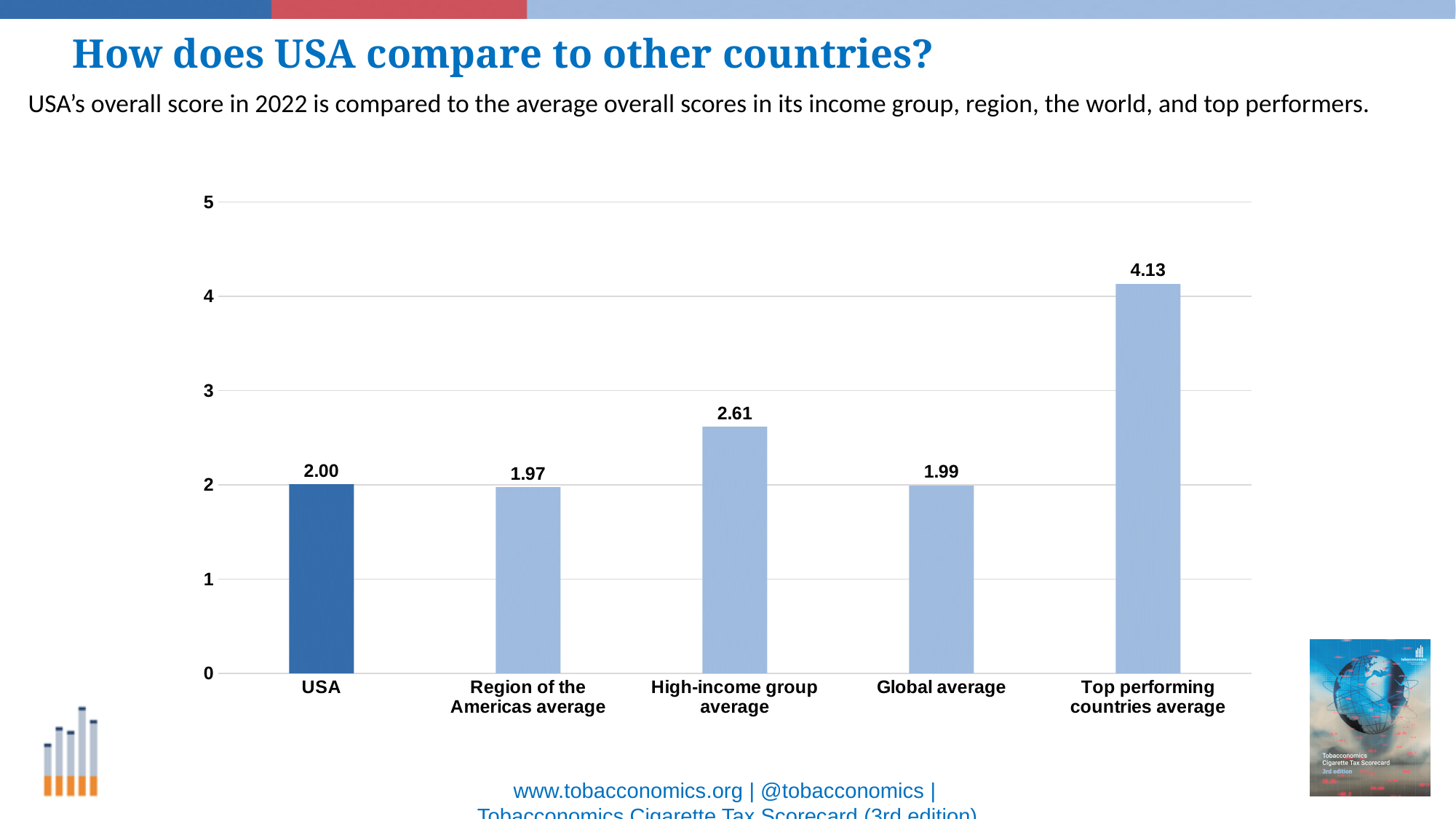
Is the value for Top performing countries average greater or less than 4? greater What is the difference between the Top performing countries average and USA? 2.13 What is the value for Global average? 1.99 What is the value for USA? 2.00 What is the value for Region of the Americas average? 1.97 What is the value for Top performing countries average? 4.13 What kind of chart is shown on the slide? Bar chart How many categories are shown on the chart? 5 Which is larger, the value for High-income group average or the value for USA? High-income group average Which category has the lowest value? Region of the Americas average Which category has the highest value? Top performing countries average What is the value for High-income group average? 2.61